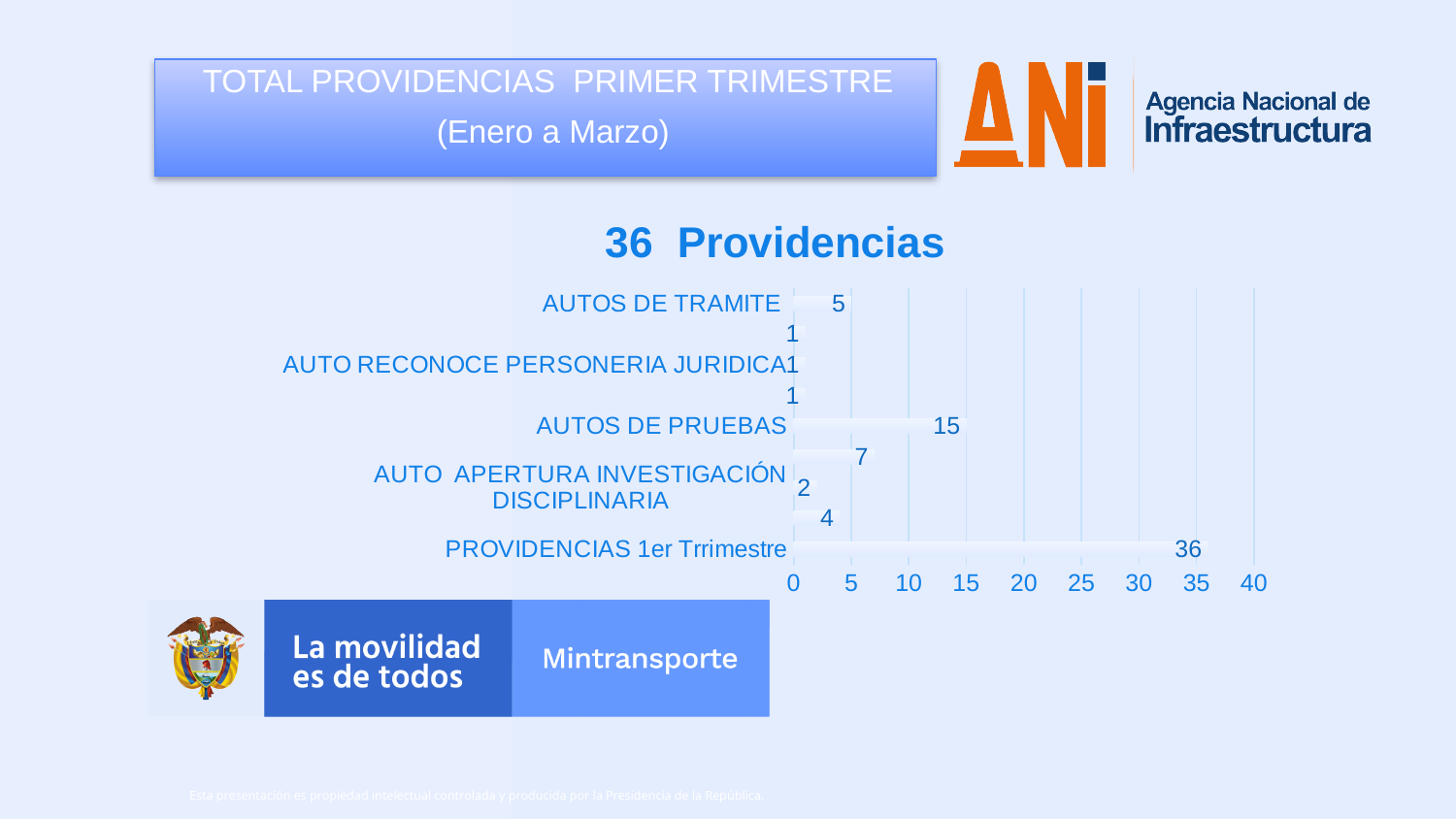
Which labeled category has the lowest value? AUTO RECONOCE PERSONERIA JURIDICA What is the value for AUTOS DE TRAMITE? 5 What is the value for AUTO RECONOCE PERSONERIA JURIDICA? 1 What is the heading shown above the chart? 36 Providencias What is the value for AUTO APERTURA INVESTIGACIÓN DISCIPLINARIA? 2 What is the difference between the values for PROVIDENCIAS 1er Trrimestre and AUTOS DE PRUEBAS? 21 What is the value for AUTOS DE PRUEBAS? 15 Which labeled category has the highest value? PROVIDENCIAS 1er Trrimestre What is the value for PROVIDENCIAS 1er Trrimestre? 36 What is the difference between the values for AUTOS DE PRUEBAS and AUTOS DE TRAMITE? 10 Which is larger, the value for AUTOS DE PRUEBAS or the value for AUTOS DE TRAMITE? AUTOS DE PRUEBAS What kind of chart is shown on the slide? bar chart